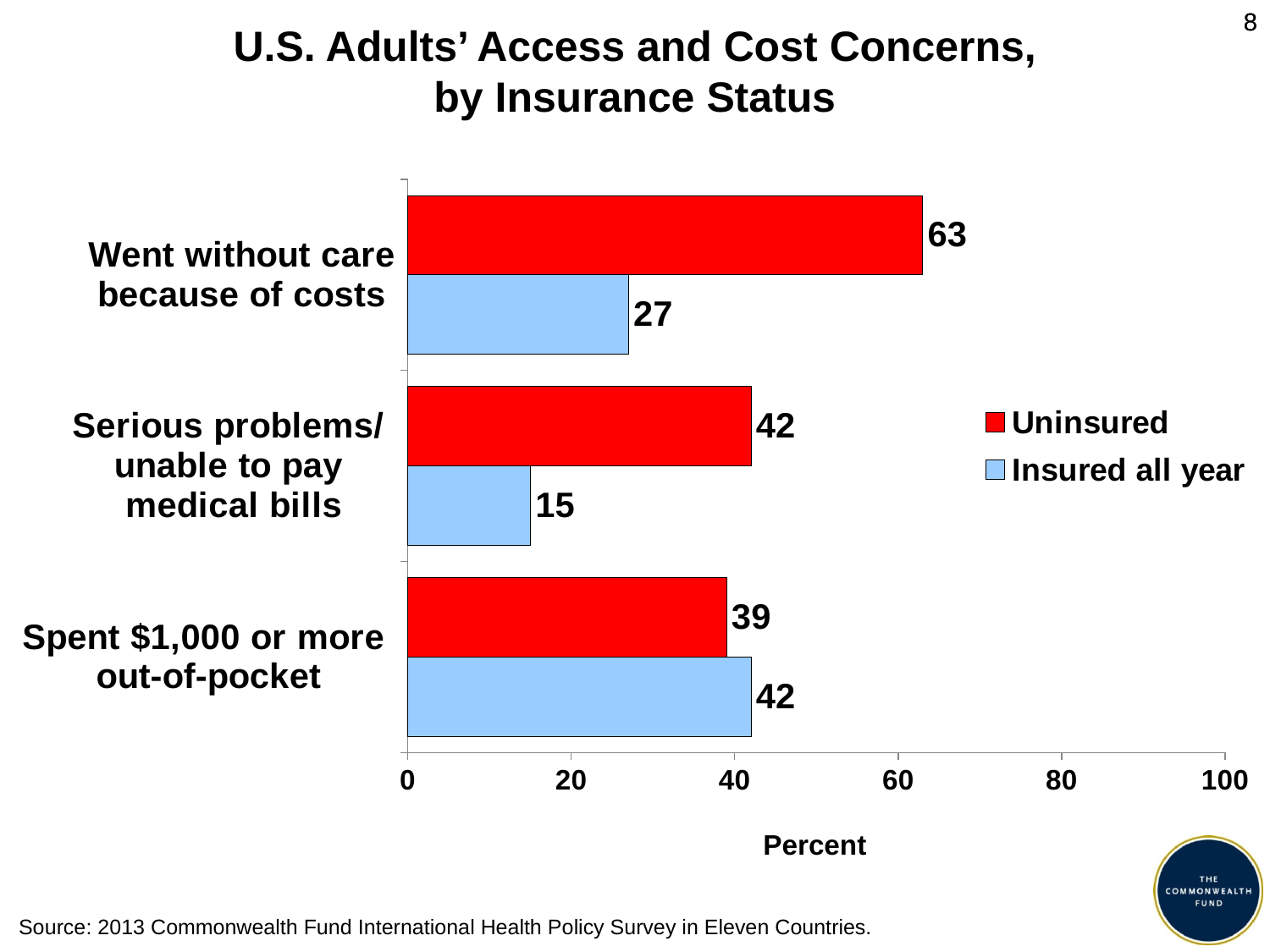
What kind of chart is shown on the slide? Bar chart How many categories are shown on the chart? 3 Which category has the lowest value for the Insured all year series? Serious problems/unable to pay medical bills Which category has the highest value for the Uninsured series? Went without care because of costs What percent of adults insured all year had serious problems or were unable to pay medical bills? 15 For spending $1,000 or more out-of-pocket, which group has the larger value, Uninsured or Insured all year? Insured all year How many series does the legend list? 2 What percent of uninsured adults went without care because of costs? 63 What percent of adults insured all year spent $1,000 or more out-of-pocket? 42 Is the Uninsured value for serious problems/unable to pay medical bills greater or less than 40? greater What is the difference between the Uninsured and Insured all year values for going without care because of costs? 36 What colour represents the Uninsured series? Red